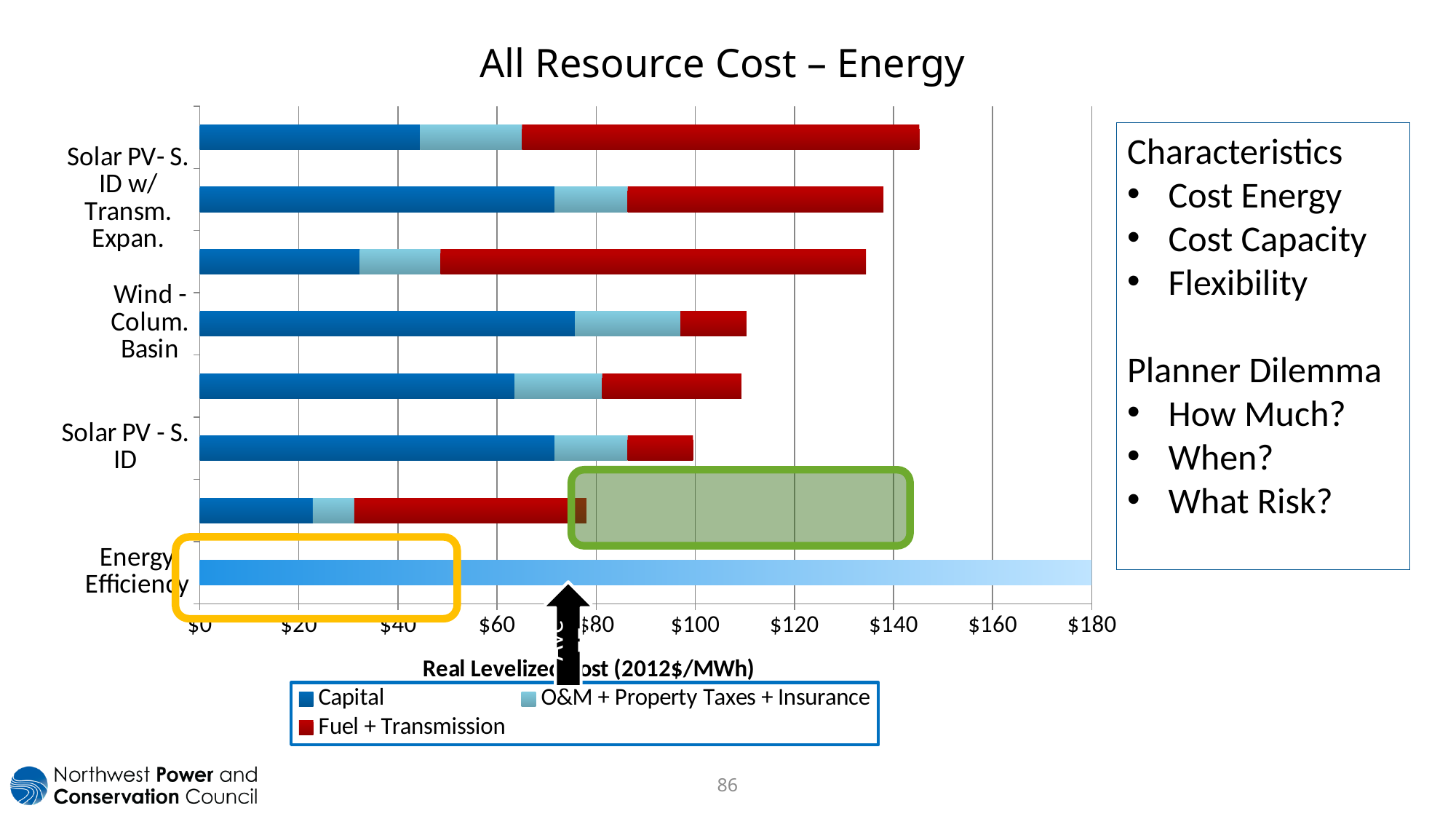
How many bars are plotted in the chart? 8 Is the total of the topmost bar greater or less than $120? greater What is the title of the chart? All Resource Cost – Energy Is the value for Energy Efficiency greater or less than $160? greater Which category's bar extends furthest along the x axis? Energy Efficiency What is the highest value shown on the x axis? $180 What is the x-axis title of the chart? Real Levelized Cost (2012$/MWh) What type of chart is shown on the slide? Stacked bar chart How many series does the legend list? 3 Is the total of the topmost bar greater or less than the total of the bar directly below it? greater